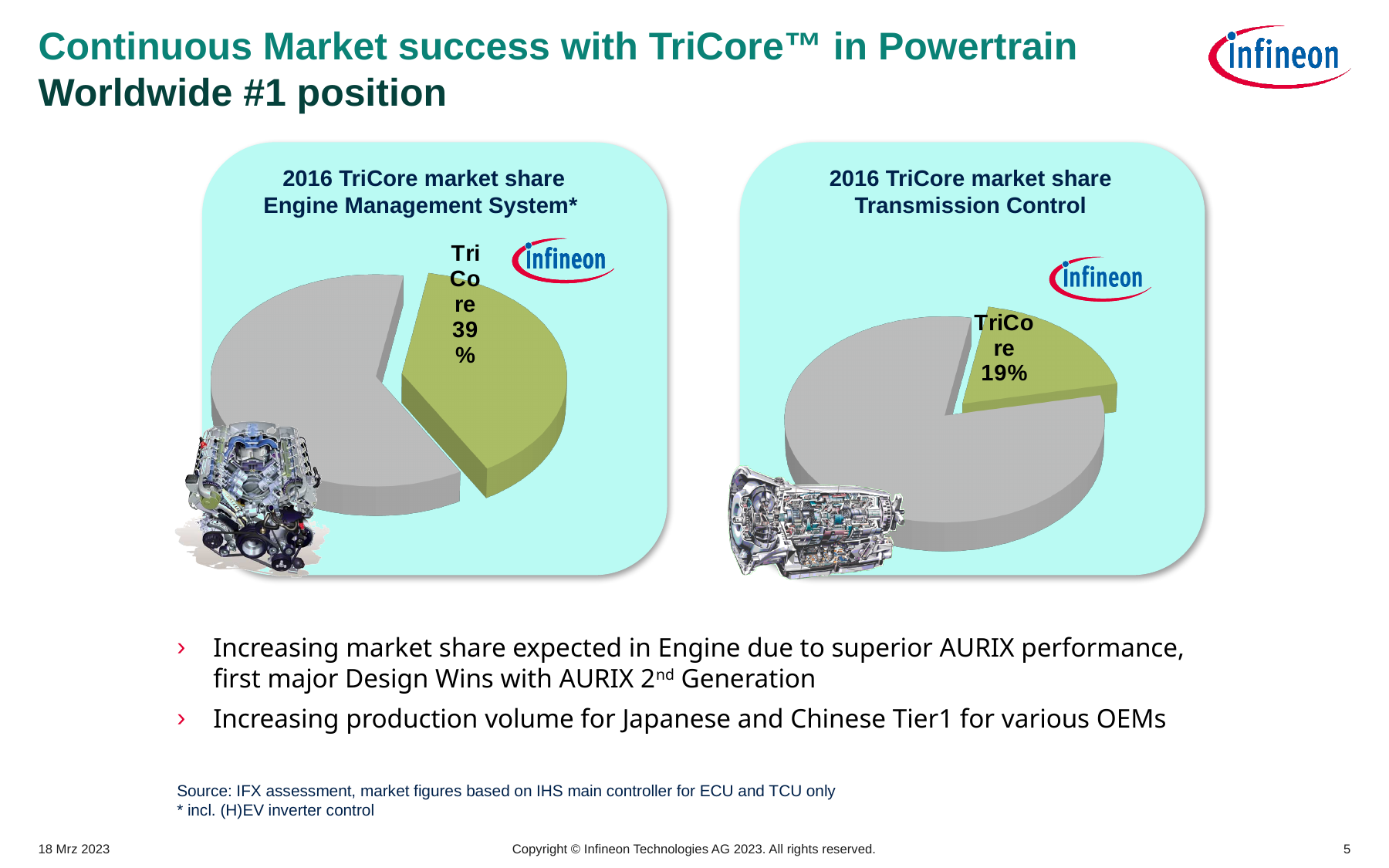
What is the title of the left pie chart on the slide? 2016 TriCore market share Engine Management System* In the 2016 TriCore market share Transmission Control chart, is the TriCore slice larger or smaller than the grey slice? Smaller How many slices does the 2016 TriCore market share Engine Management System pie chart have? 2 In the 2016 TriCore market share Transmission Control chart, what is the TriCore share? 19% By how many percentage points does the TriCore share in the Engine Management System chart exceed the TriCore share in the Transmission Control chart? 20 percentage points What kind of chart is the 2016 TriCore market share Transmission Control chart? Pie chart In the 2016 TriCore market share Engine Management System chart, is the TriCore slice larger or smaller than the grey slice? Smaller Is the TriCore share larger in the Engine Management System chart or in the Transmission Control chart? Engine Management System What colour is the TriCore slice in the 2016 TriCore market share Transmission Control chart? Green What kind of chart is the 2016 TriCore market share Engine Management System chart? Pie chart How many slices does the 2016 TriCore market share Transmission Control pie chart have? 2 In the 2016 TriCore market share Engine Management System chart, what is the TriCore share? 39%